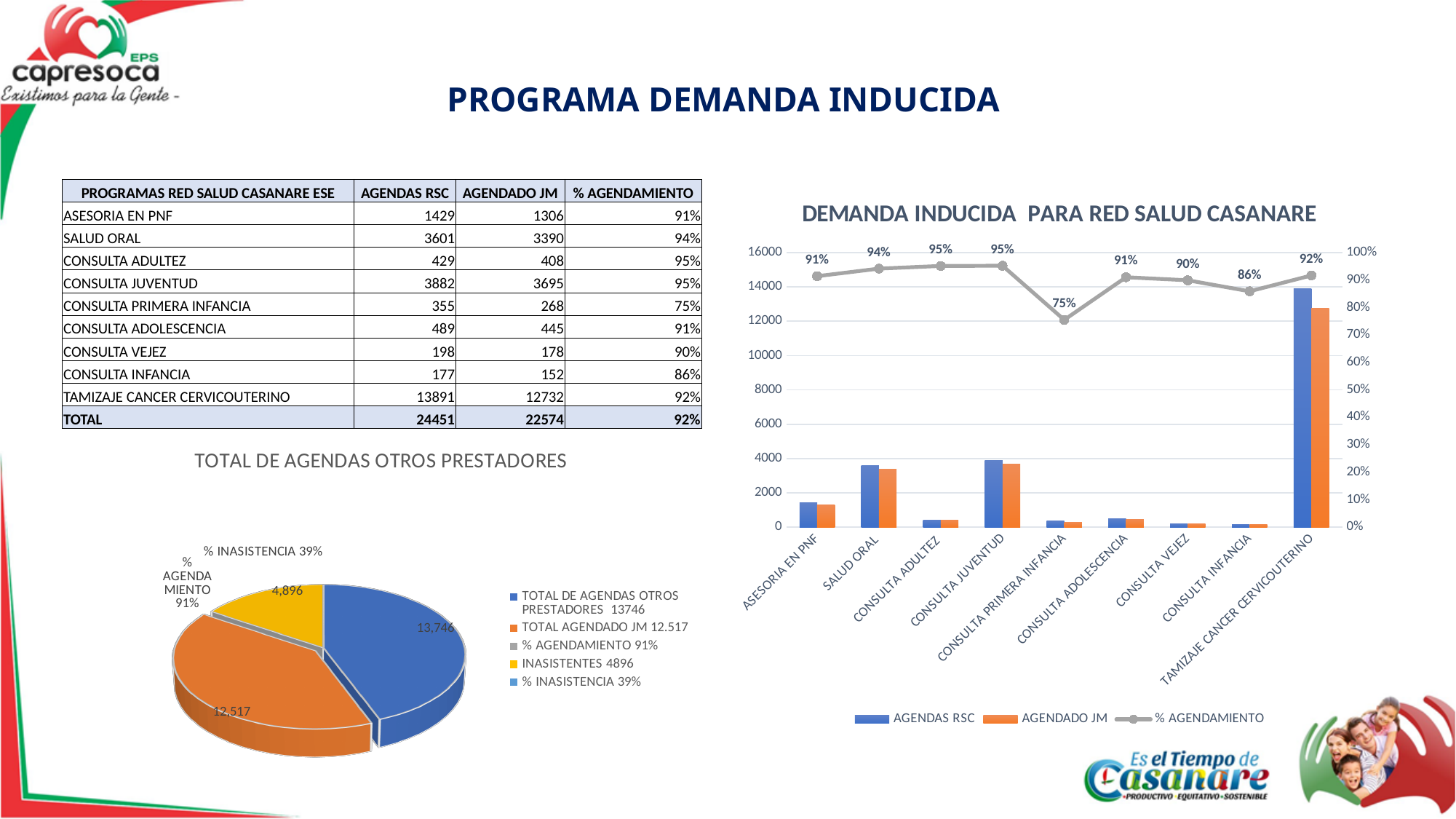
In the chart titled DEMANDA INDUCIDA PARA RED SALUD CASANARE, is the AGENDADO JM value for SALUD ORAL greater or less than 4000? less In the chart titled DEMANDA INDUCIDA PARA RED SALUD CASANARE, what is the % AGENDAMIENTO value for SALUD ORAL? 94% In the chart titled DEMANDA INDUCIDA PARA RED SALUD CASANARE, which category has the lowest % AGENDAMIENTO? CONSULTA PRIMERA INFANCIA In the pie chart titled TOTAL DE AGENDAS OTROS PRESTADORES, how many entries does the legend list? 5 What kind of chart is the one titled TOTAL DE AGENDAS OTROS PRESTADORES? Pie chart In the pie chart titled TOTAL DE AGENDAS OTROS PRESTADORES, what value is shown on the orange slice? 12,517 In the chart titled DEMANDA INDUCIDA PARA RED SALUD CASANARE, is the AGENDAS RSC value for TAMIZAJE CANCER CERVICOUTERINO greater or less than 12000? greater In the chart titled DEMANDA INDUCIDA PARA RED SALUD CASANARE, what is the % AGENDAMIENTO value for CONSULTA PRIMERA INFANCIA? 75% In the chart titled DEMANDA INDUCIDA PARA RED SALUD CASANARE, which category has the tallest AGENDAS RSC bar? TAMIZAJE CANCER CERVICOUTERINO In the chart titled DEMANDA INDUCIDA PARA RED SALUD CASANARE, how many series does the legend list? 3 In the chart titled DEMANDA INDUCIDA PARA RED SALUD CASANARE, how many categories are shown on the x axis? 9 In the chart titled DEMANDA INDUCIDA PARA RED SALUD CASANARE, what is the difference between the % AGENDAMIENTO for CONSULTA JUVENTUD and CONSULTA INFANCIA? 9%